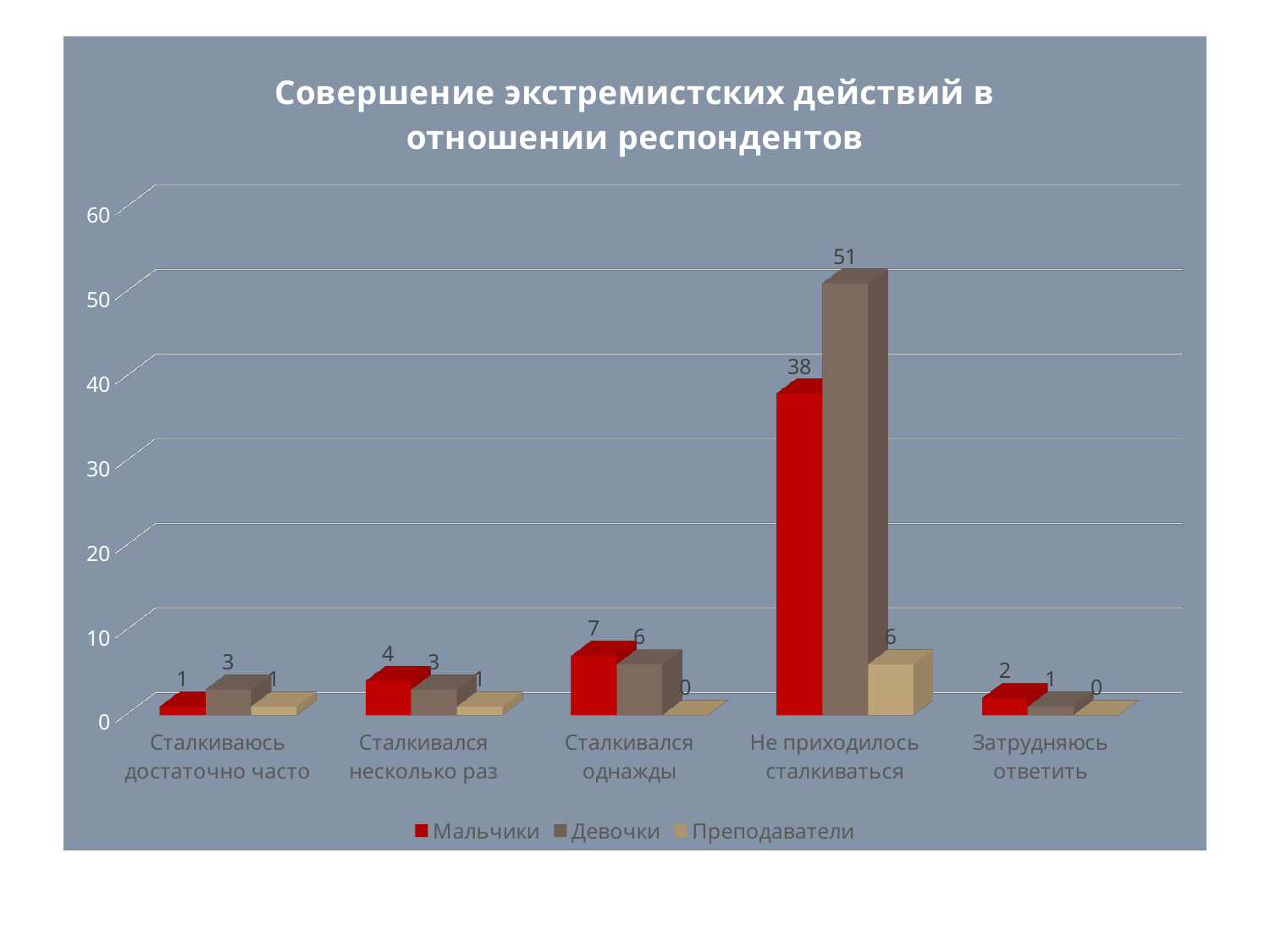
What is the difference between the Девочки and Мальчики values in the category 'Не приходилось сталкиваться'? 13 Which is larger in the category 'Сталкивался несколько раз': the value for Мальчики or for Девочки? Мальчики Which category has the highest value for Мальчики? Не приходилось сталкиваться Is the value for Мальчики in 'Не приходилось сталкиваться' greater or less than 30? greater What is the title of the chart? Совершение экстремистских действий в отношении респондентов What is the value for Девочки in the category 'Не приходилось сталкиваться'? 51 What is the value for Мальчики in the category 'Сталкивался однажды'? 7 What kind of chart is shown on the slide? bar chart How many series does the legend list? 3 What is the value for Преподаватели in the category 'Не приходилось сталкиваться'? 6 How many categories are shown on the x axis? 5 What is the total of the three series in the category 'Сталкивался однажды'? 13